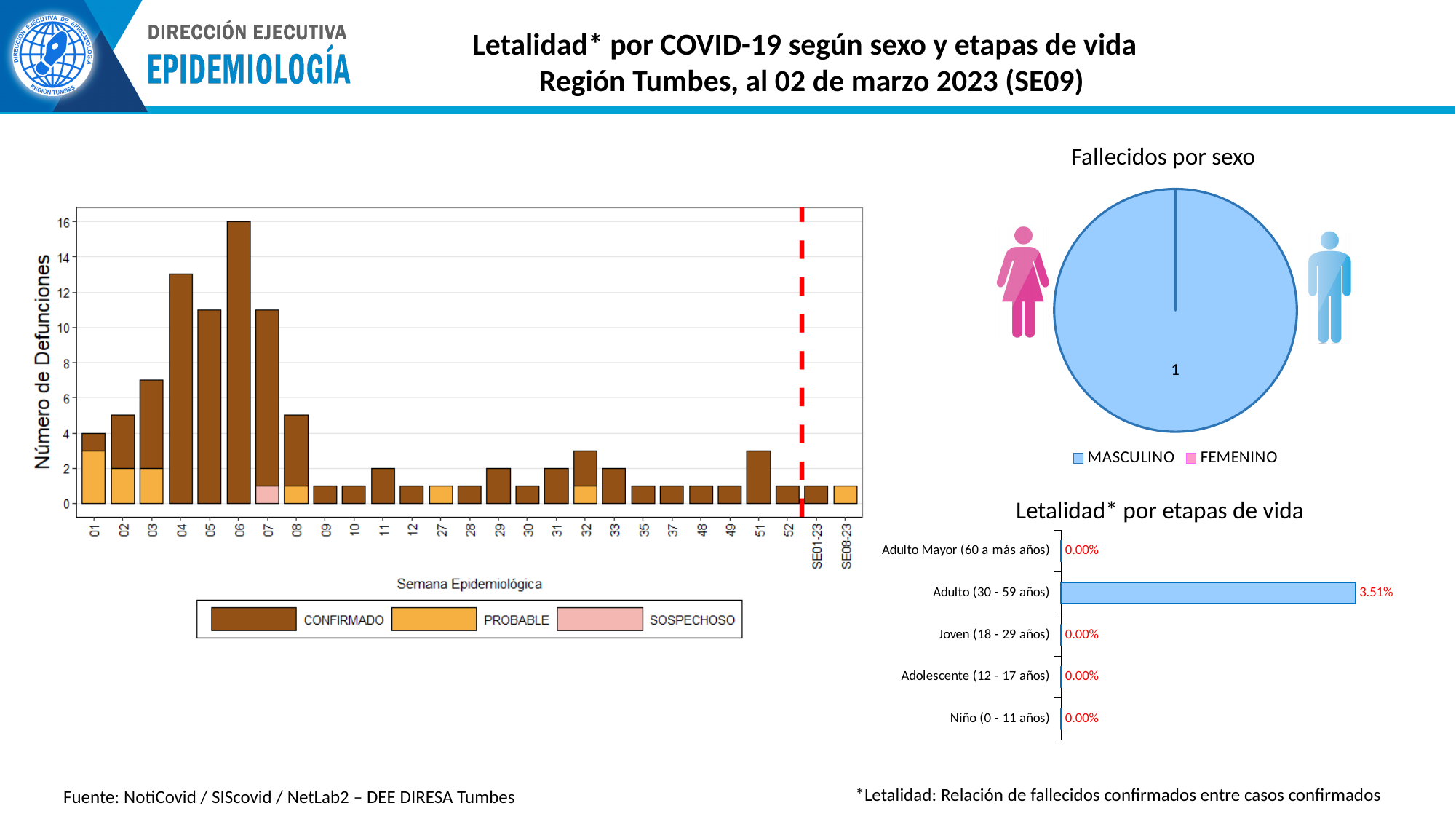
In the left chart of deaths by epidemiological week, what is the total number of deaths in week 06? 16 What kind of chart is 'Letalidad* por etapas de vida'? Bar chart In the left chart of deaths by epidemiological week, which is larger: the total for week 05 or the total for week 08? Week 05 In the left chart of deaths by epidemiological week, which week has the highest number of deaths? 06 In the 'Fallecidos por sexo' pie chart, what value is printed on the MASCULINO slice? 1 In the 'Letalidad* por etapas de vida' chart, which age group has the highest value? Adulto (30 - 59 años) How many age-group categories are shown in the 'Letalidad* por etapas de vida' chart? 5 How many series does the legend of the left chart of deaths by epidemiological week list? 3 In the 'Letalidad* por etapas de vida' chart, what is the value for Adulto Mayor (60 a más años)? 0.00% In the 'Letalidad* por etapas de vida' chart, what is the value for Adulto (30 - 59 años)? 3.51% In the left chart of deaths by epidemiological week, is the total for week 04 greater or less than 12? greater How many series does the legend of the 'Fallecidos por sexo' chart list? 2